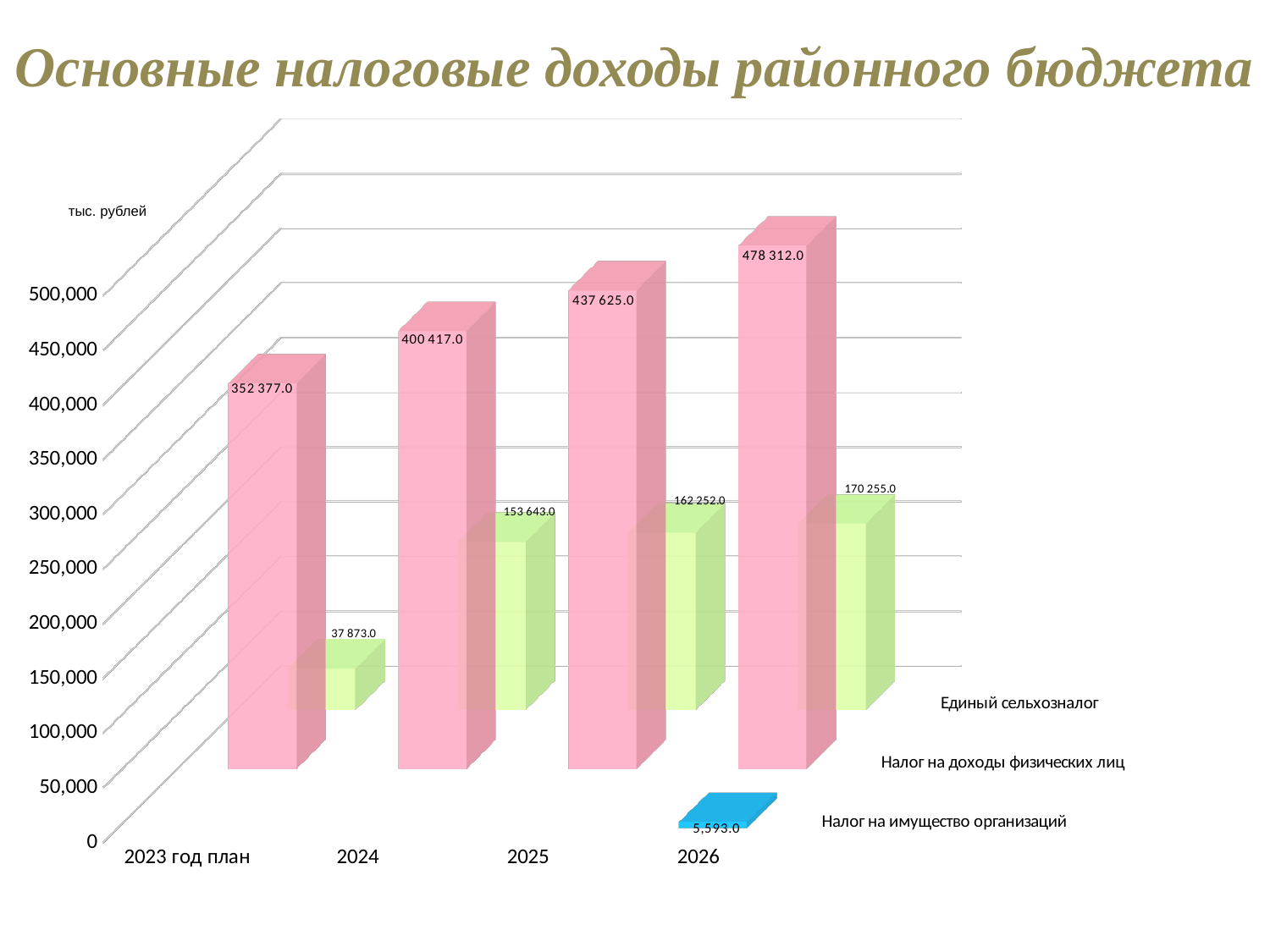
In which year is the pink bar the highest? 2026 What is the value of the green bar for 2024? 153 643.0 What is the value of the green bar for 2026? 170 255.0 What is the value of the blue bar for 2026? 5,593.0 Do the pink bar values rise or fall from 2023 год план to 2026? Rise What is the value of the pink bar for 2023 год план? 352 377.0 In which year is the green bar the lowest? 2023 год план What is the difference between the pink bar values for 2026 and 2023 год план? 125 935.0 How many year categories are shown on the x axis? 4 What is the title of the chart? Основные налоговые доходы районного бюджета What is the value of the pink bar for 2026? 478 312.0 Which is larger for 2025, the pink bar or the green bar? The pink bar